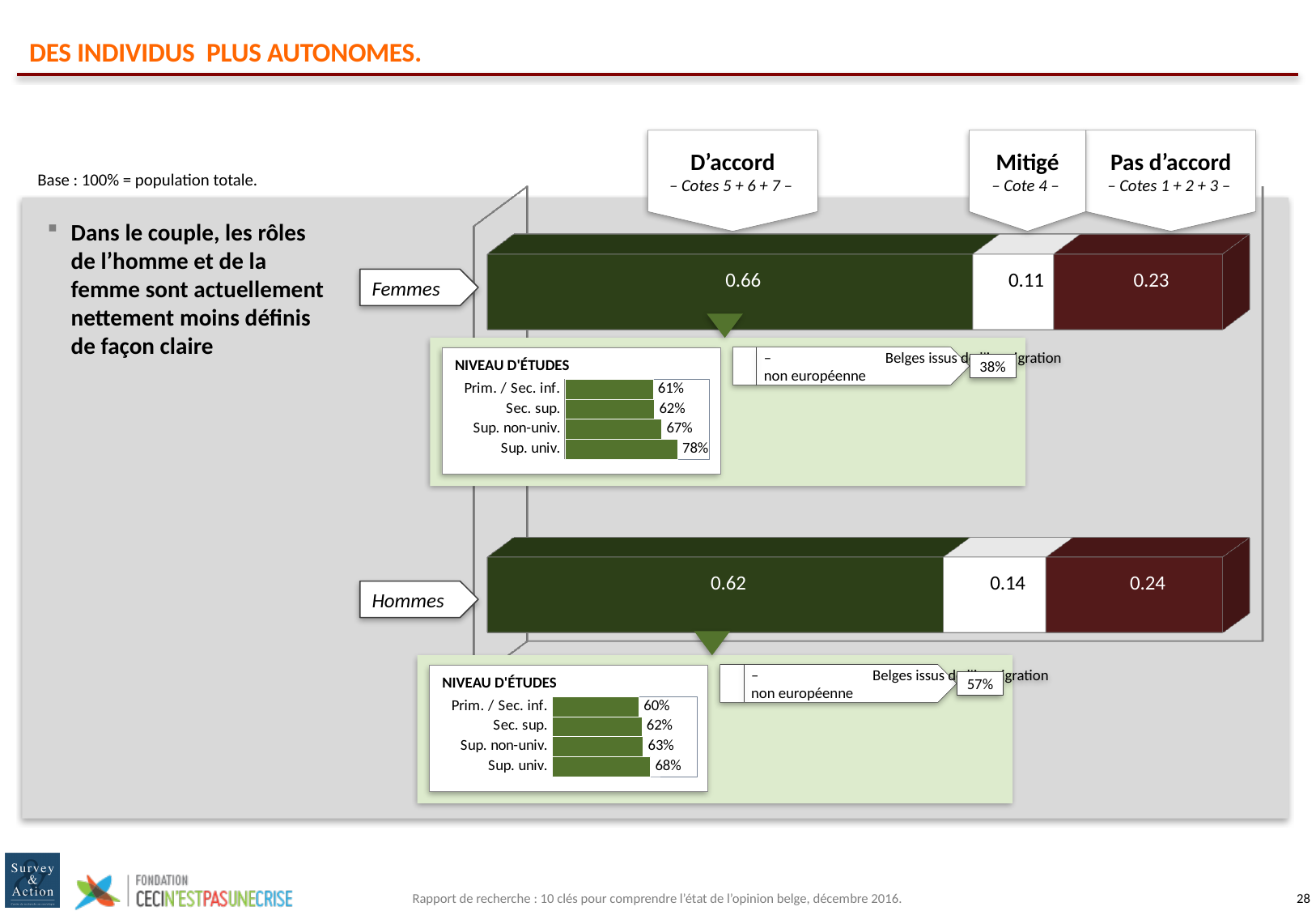
In the Niveau d'études chart under Femmes, which category has the lowest value? Prim. / Sec. inf. In the Hommes stacked bar, what is the value for Mitigé? 0.14 In the Hommes stacked bar, what is the value for Pas d'accord? 0.24 In the Niveau d'études chart under Hommes, what is the value for Sup. non-univ.? 63% In the Niveau d'études chart under Femmes, what is the value for Sup. univ.? 78% In the Niveau d'études chart under Hommes, which category has the highest value? Sup. univ. What kind of chart is the Niveau d'études chart under Femmes? Bar chart What is the difference between the Sup. univ. values in the Femmes and Hommes Niveau d'études charts? 10% In the Femmes stacked bar, what is the value for D'accord? 0.66 What is the difference between the Pas d'accord values for Hommes and Femmes? 0.01 How many categories are shown in the Niveau d'études chart under Hommes? 4 Which is larger: the D'accord value for Femmes or the D'accord value for Hommes? Femmes